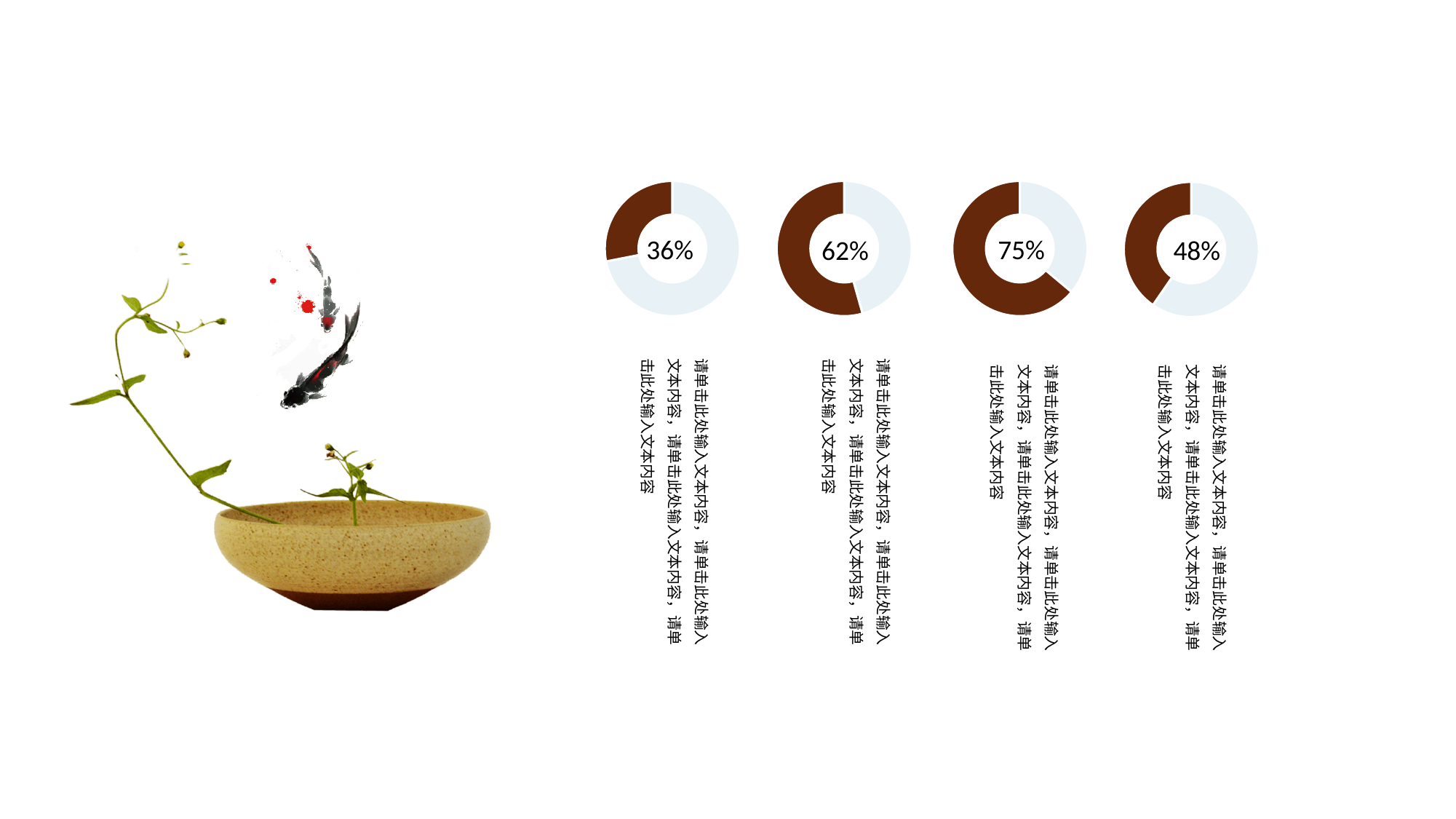
What colour is the filled (highlighted) portion of each donut chart? Brown What value is shown in the centre of the second donut chart from the left? 62% What value is shown in the centre of the rightmost donut chart? 48% What value is shown in the centre of the leftmost donut chart? 36% Is the value shown in the rightmost donut chart greater or less than 50%? less Which is larger: the percentage in the second donut chart or the percentage in the rightmost donut chart? The second donut chart (62%) What is the difference between the percentage in the third donut chart and the percentage in the leftmost donut chart? 39% How many donut charts are shown on the slide? 4 Which of the four donut charts shows the highest percentage? The third from the left (75%) Which of the four donut charts shows the lowest percentage? The leftmost (36%) What value is shown in the centre of the third donut chart from the left? 75% What kind of chart is used to display the percentages on the slide? Donut chart